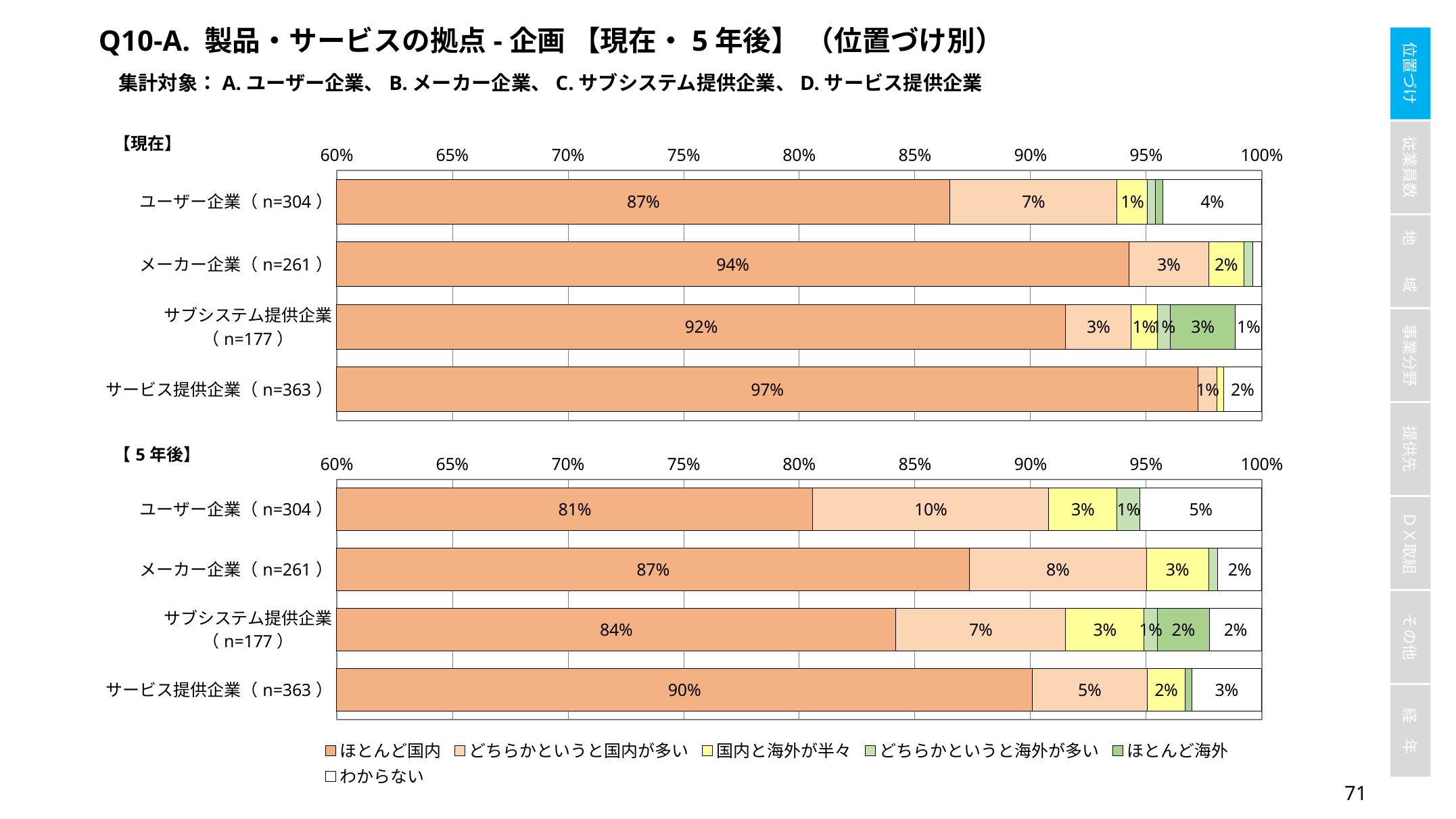
What is the first entry in the legend? ほとんど国内 In the 【現在】 chart, what is the value of ほとんど海外 for サブシステム提供企業 (n=177)? 3% What kind of chart is the 【現在】 chart? Stacked bar chart In the 【5年後】 chart, what is the value of どちらかというと国内が多い for ユーザー企業 (n=304)? 10% In the 【現在】 chart, what is the difference between the ほとんど国内 values for メーカー企業 (n=261) and ユーザー企業 (n=304)? 7% How many series does the legend list? 6 In the 【5年後】 chart, which category has the lowest value for ほとんど国内? ユーザー企業 (n=304) In the 【5年後】 chart, what is the value of わからない for メーカー企業 (n=261)? 2% In the 【現在】 chart, what is the value of ほとんど国内 for サービス提供企業 (n=363)? 97% In the 【現在】 chart, which category has the highest value for ほとんど国内? サービス提供企業 (n=363) In the 【5年後】 chart, which is larger: the ほとんど国内 value for サブシステム提供企業 (n=177) or for サービス提供企業 (n=363)? サービス提供企業 (n=363) How many categories are shown in the 【5年後】 chart? 4